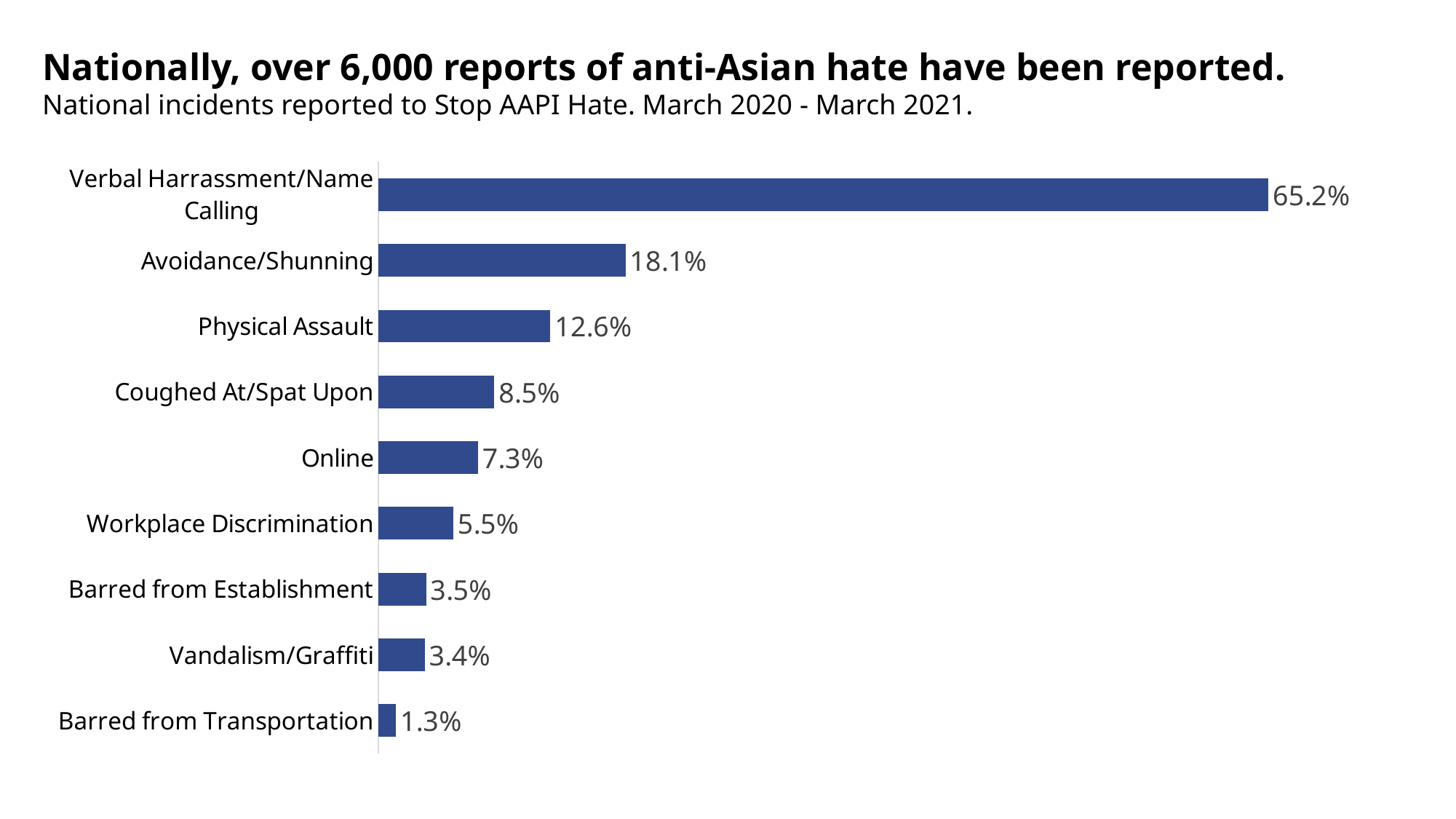
Which category has the lowest value? Barred from Transportation Which category has the highest value? Verbal Harrassment/Name Calling What colour are the bars in the chart? Blue How many categories are shown in the chart? 9 What kind of chart is shown on the slide? Bar chart What percentage of incidents were Verbal Harrassment/Name Calling? 65.2% What is the value for Physical Assault? 12.6% What is the subtitle of the chart? National incidents reported to Stop AAPI Hate. March 2020 - March 2021. What is the difference between Coughed At/Spat Upon and Online? 1.2% Which is larger, Online or Workplace Discrimination? Online What is the value for Workplace Discrimination? 5.5% What is the difference between Avoidance/Shunning and Physical Assault? 5.5%